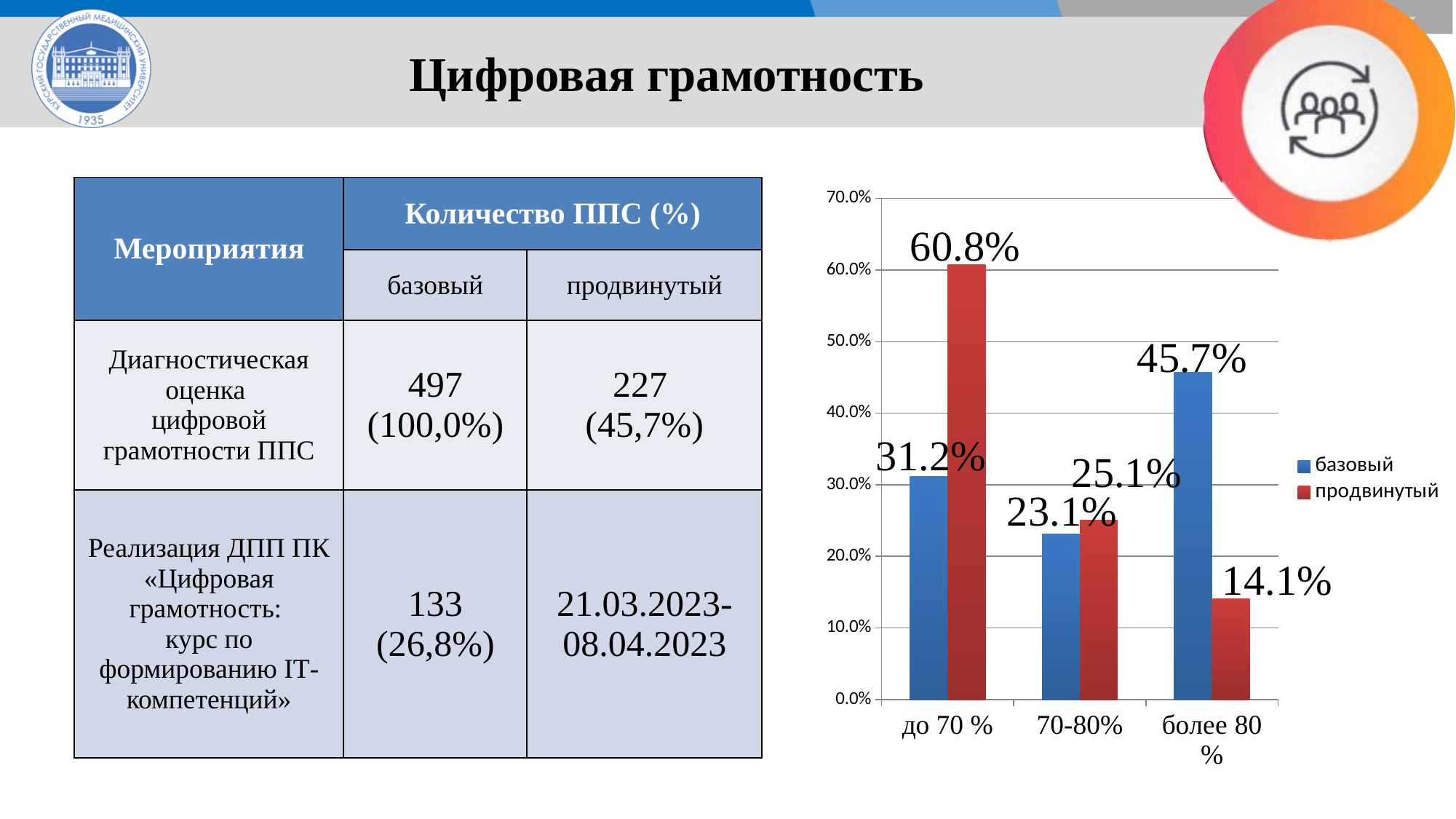
What is the difference between продвинутый and базовый in the category до 70 %? 29.6% What kind of chart is shown on the slide? bar chart How many series does the chart legend list? 2 What is the value for продвинутый in the category до 70 %? 60.8% Which is larger in the category более 80 %: базовый or продвинутый? базовый How many categories are shown on the x axis of the chart? 3 What is the value for продвинутый in the category 70-80%? 25.1% Do the values for the продвинутый series rise or fall from до 70 % to более 80 %? fall What is the value for базовый in the category до 70 %? 31.2% Which category has the highest value for the продвинутый series? до 70 % Which category has the lowest value for the базовый series? 70-80% What is the value for базовый in the category более 80 %? 45.7%